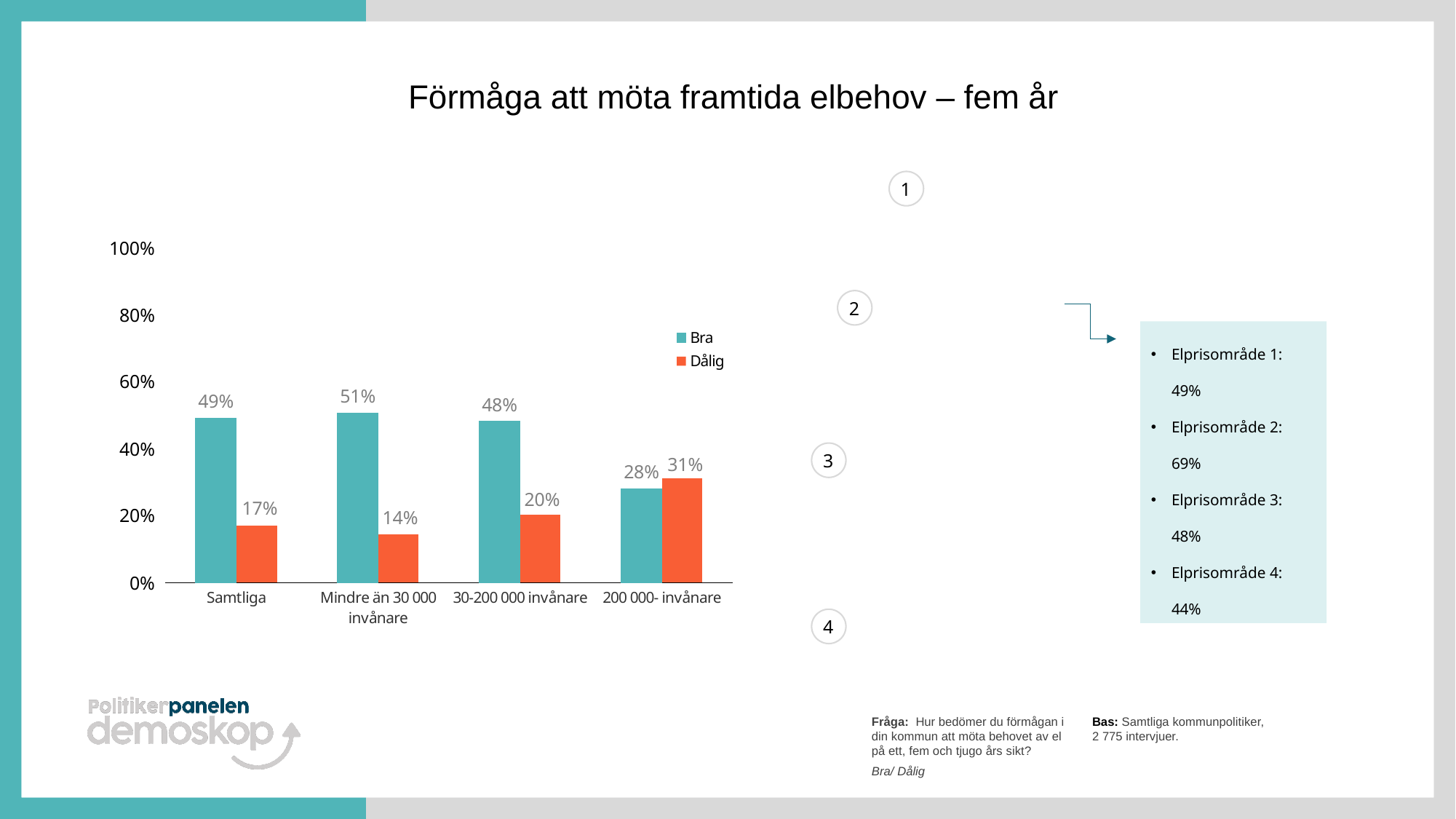
What is the Bra value for Samtliga? 49% What is the title of the chart? Förmåga att möta framtida elbehov – fem år Is the Bra value for 200 000- invånare greater or less than 40%? less What is the difference between the Bra and Dålig values for 30-200 000 invånare? 28% Which category has the highest Bra value? Mindre än 30 000 invånare What kind of chart is shown? bar chart Which category has the lowest Dålig value? Mindre än 30 000 invånare What is the Dålig value for 200 000- invånare? 31% For 200 000- invånare, which is larger, Bra or Dålig? Dålig How many series does the legend list? 2 What is the Dålig value for Mindre än 30 000 invånare? 14% How many categories are shown on the x axis? 4